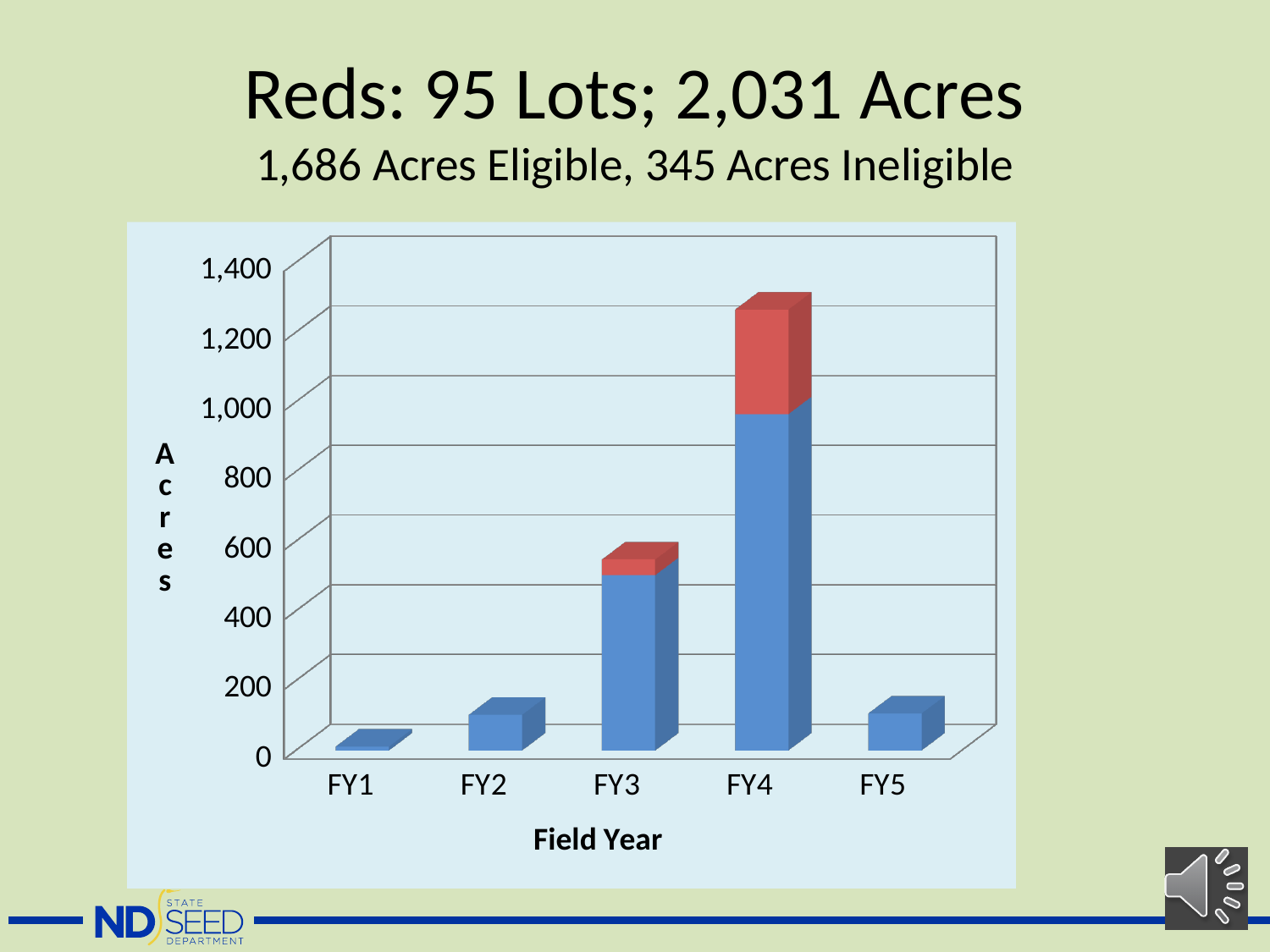
What is the title of the y axis of the chart? Acres Which field year has the tallest bar in the chart? FY4 Which bar is taller, FY3 or FY2? FY3 Is the bar for FY2 greater or less than 200 acres? less Is the total bar height for FY3 greater or less than 800 acres? less What kind of chart is shown on the slide? bar chart Which field year has the shortest bar in the chart? FY1 What is the title of the x axis of the chart? Field Year Is the total bar height for FY4 greater or less than 1,000 acres? greater How many field years are shown on the x axis of the chart? 5